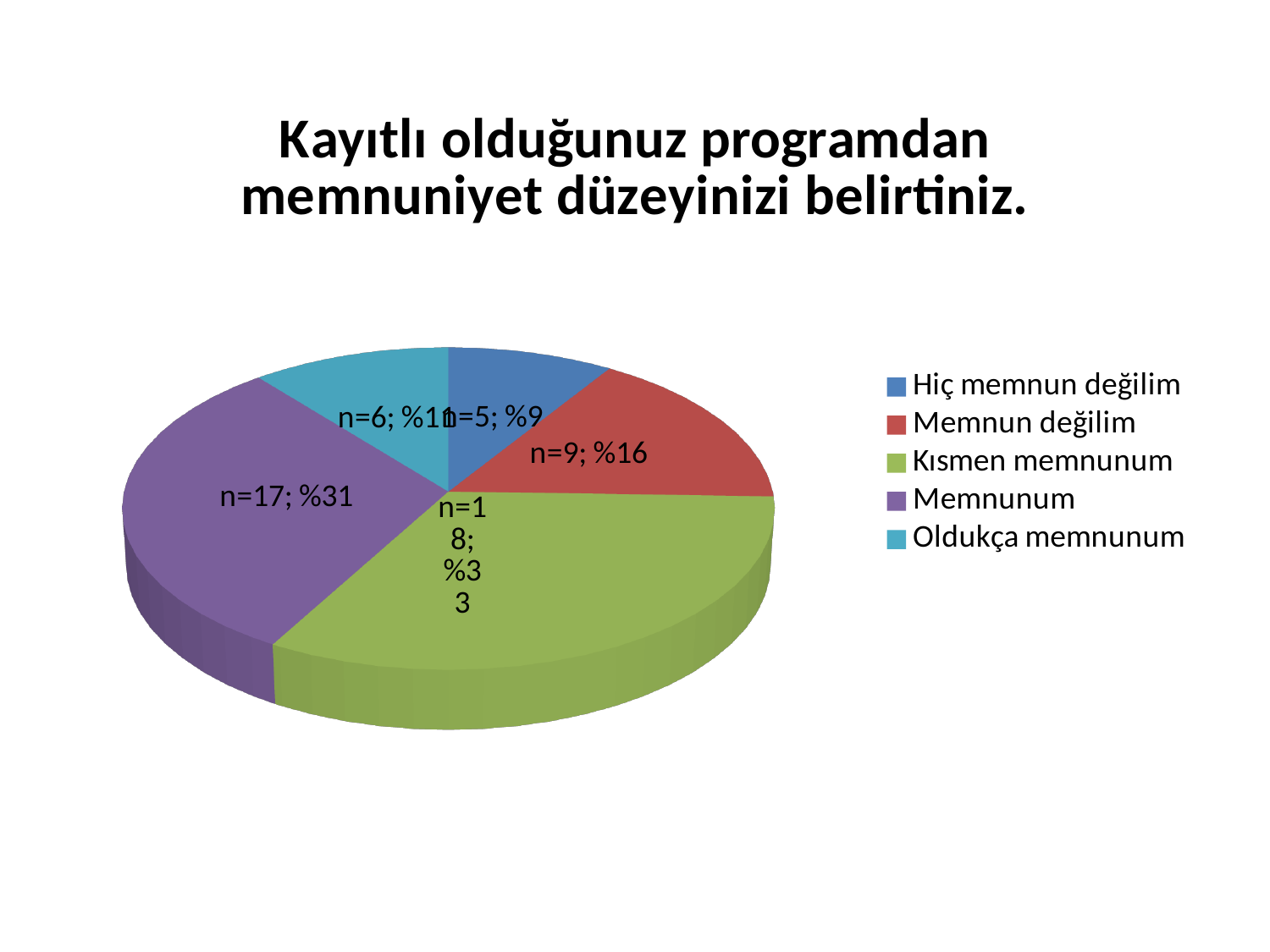
What percentage is shown for the Memnunum slice? %31 What colour is the Memnunum slice in the pie chart? purple What kind of chart is shown on the slide? pie chart How many respondents (n) are in the Memnun değilim slice? n=9 How many categories does the legend of the pie chart list? 5 What percentage is shown for the Hiç memnun değilim slice? %9 Which slice is larger, Memnunum or Memnun değilim? Memnunum How many respondents (n) are in the Oldukça memnunum slice? n=6 Which category has the largest slice of the pie? Kısmen memnunum What is the difference in n between the Kısmen memnunum slice and the Memnunum slice? 1 Which category has the smallest slice of the pie? Hiç memnun değilim What is the data label for the Kısmen memnunum slice? n=18; %33